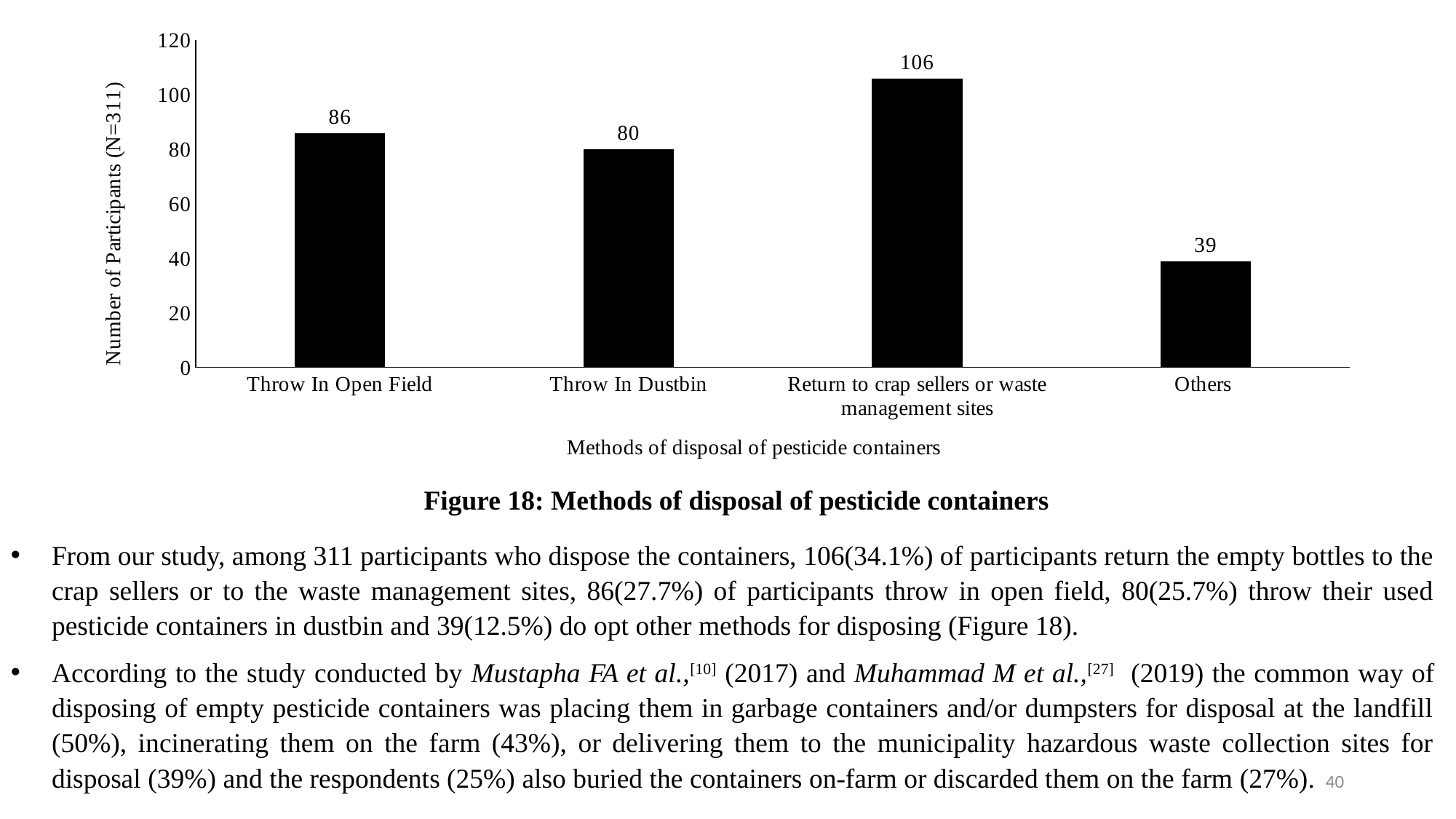
How many disposal method categories are shown in the chart? 4 What is the label of the y-axis of the chart? Number of Participants (N=311) What is the difference between the number of participants who throw in open field and those who throw in dustbin? 6 What is the number of participants for 'Throw In Dustbin'? 80 What type of chart is shown on the slide? Bar chart What is the value for the 'Others' category? 39 Which disposal method has the highest number of participants? Return to crap sellers or waste management sites How many participants return containers to crap sellers or waste management sites? 106 How many more participants return containers to crap sellers or waste management sites than choose other methods? 67 Which disposal method has the lowest number of participants? Others How many participants throw pesticide containers in an open field? 86 Which has more participants: 'Throw In Open Field' or 'Throw In Dustbin'? Throw In Open Field